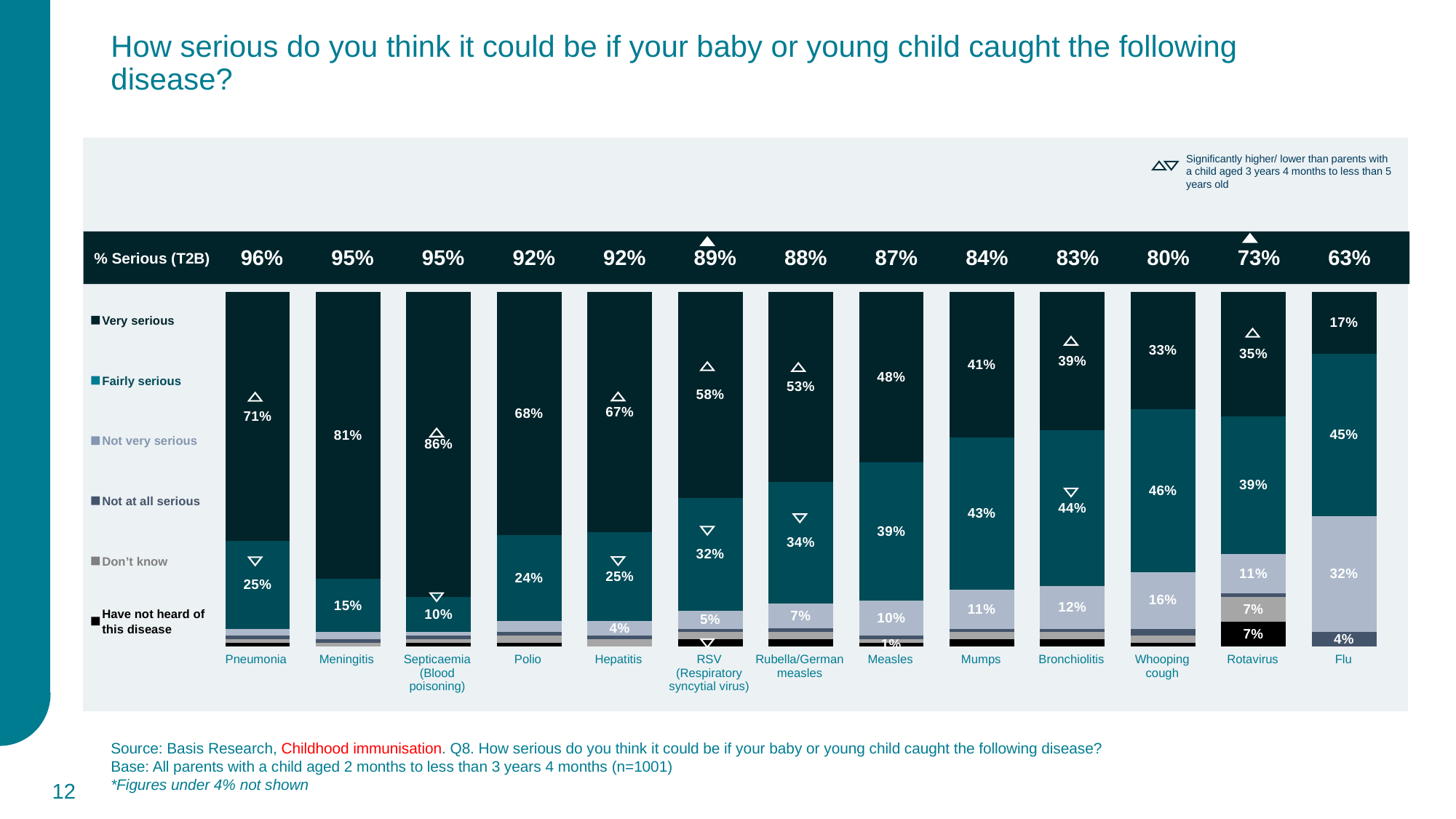
Which has a higher 'fairly serious' percentage, measles or mumps? Mumps What is the difference between the 'very serious' percentages for meningitis and polio? 13 percentage points Which disease has the lowest % Serious (T2B) figure? Flu What is the % Serious (T2B) figure for flu? 63% What type of chart is shown on the slide? Stacked bar chart How many diseases are shown on the chart? 13 How many response categories does the legend list? 6 What percentage of parents said whooping cough would be fairly serious? 46% Which disease has the highest 'very serious' percentage? Septicaemia (Blood poisoning) Do the % Serious (T2B) figures rise or fall moving from left to right across the diseases? Fall What percentage of parents said pneumonia would be very serious? 71% What percentage of parents said flu would be not very serious? 32%